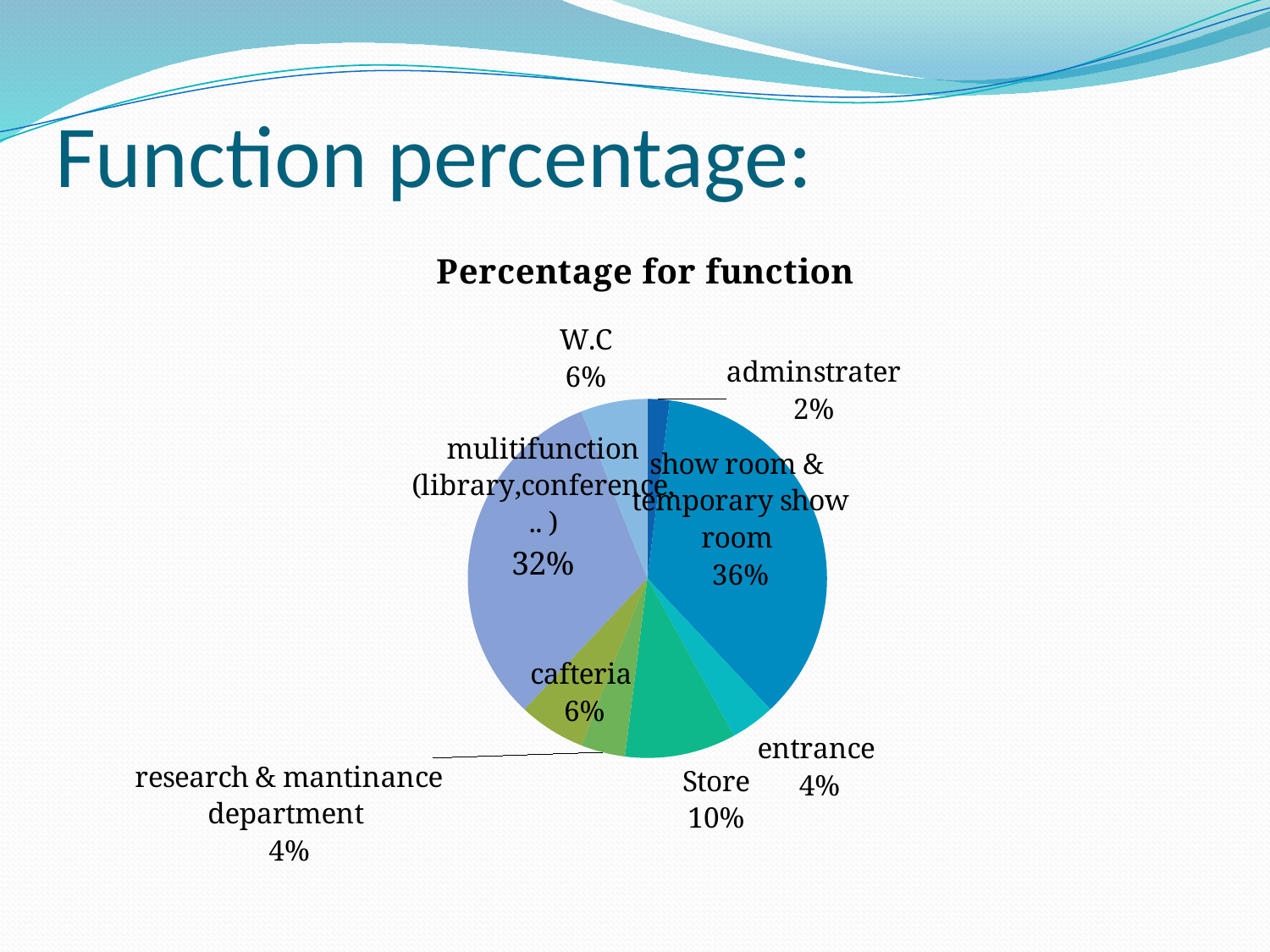
Which function has the largest share of the pie? show room & temporary show room What is the title of the chart? Percentage for function Which function has the smallest share of the pie? adminstrater What is the combined percentage of the entrance and research & mantinance department slices? 8% What percentage is shown for the Store slice? 10% What percentage does the show room & temporary show room slice represent? 36% What percentage is shown for the mulitifunction (library, conference, ..) slice? 32% What percentage is shown for the W.C slice? 6% What is the difference in percentage points between the show room & temporary show room slice and the mulitifunction slice? 4 How many slices does the pie chart have? 8 What kind of chart is shown on the slide? pie chart Which is larger, the Store slice or the cafteria slice? Store